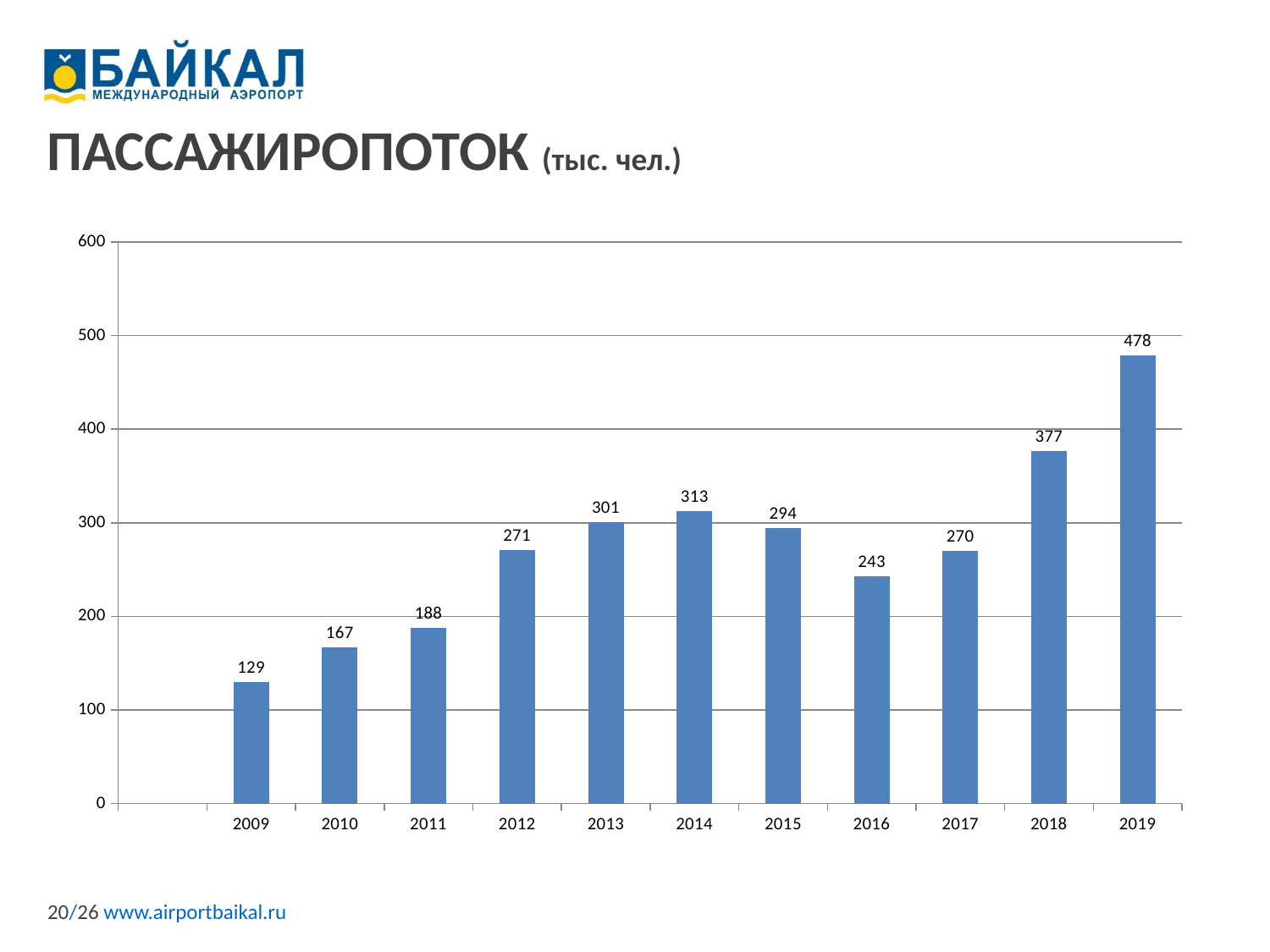
What unit is given in the chart title? тыс. чел. Which year has the lowest passenger traffic? 2009 What is the passenger traffic value for 2019? 478 Which year has the highest passenger traffic? 2019 Which is larger, the value for 2013 or the value for 2017? 2013 Is the value for 2012 greater or less than 300? less How many years are shown on the x axis? 11 What kind of chart is shown on the slide? bar chart What is the difference between the values for 2019 and 2018? 101 What is the value shown for 2016? 243 What is the difference between the values for 2014 and 2015? 19 What is the passenger traffic value for 2009? 129